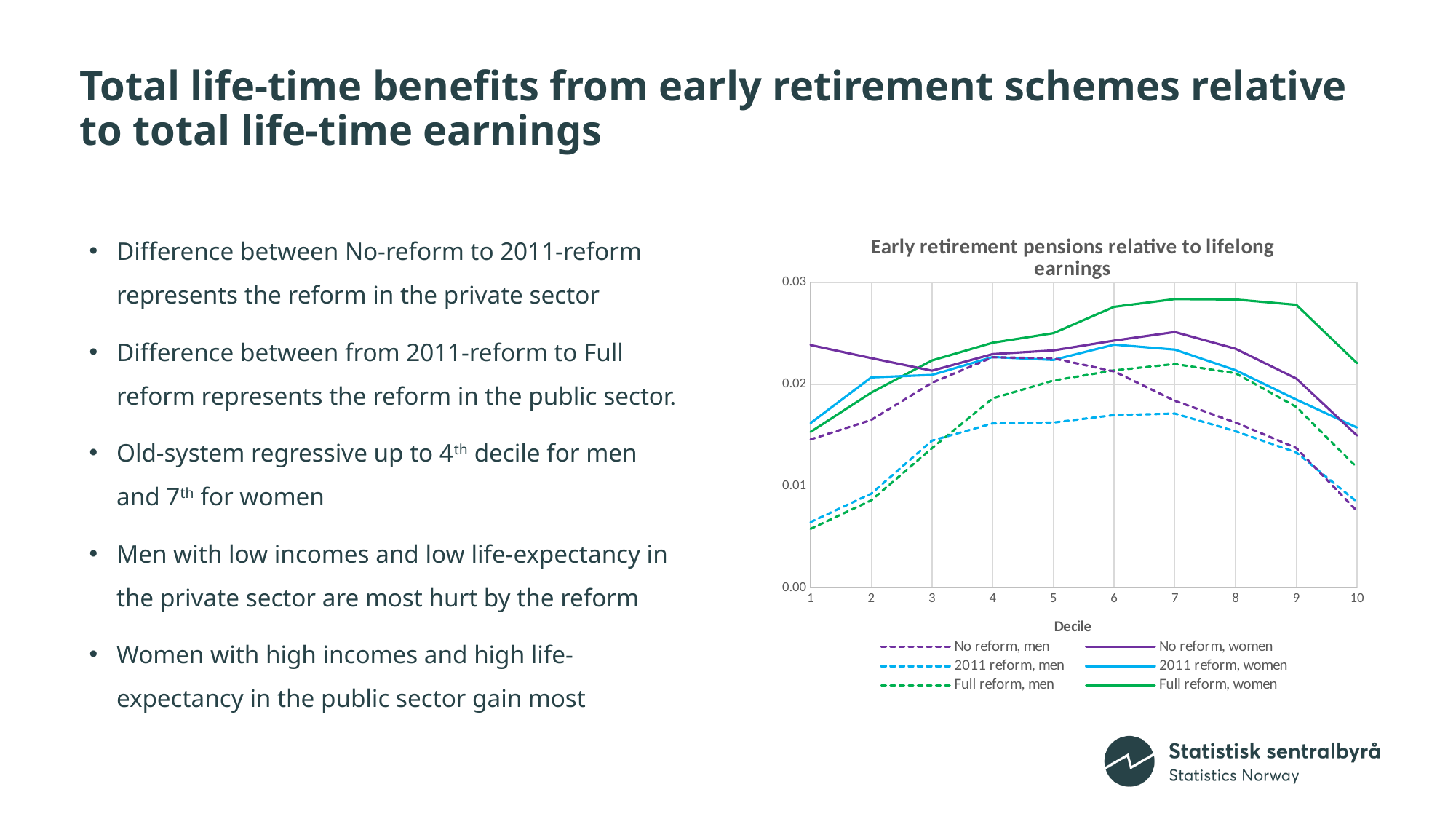
How many series does the chart legend list? 6 At which decile is the value for Full reform, men lowest? 1 Is the value for 2011 reform, men at decile 5 greater or less than 0.02? less How many deciles are plotted along the x axis of the chart? 10 What is the title of the chart? Early retirement pensions relative to lifelong earnings What is the label of the x axis of the chart? Decile Which series has the highest value at decile 7? Full reform, women Does the value for No reform, men rise or fall from decile 7 to decile 10? Fall Is the value for No reform, women at decile 1 greater or less than 0.02? greater Is the value for Full reform, women at decile 7 greater or less than 0.02? greater What kind of chart is shown on the slide? Line chart